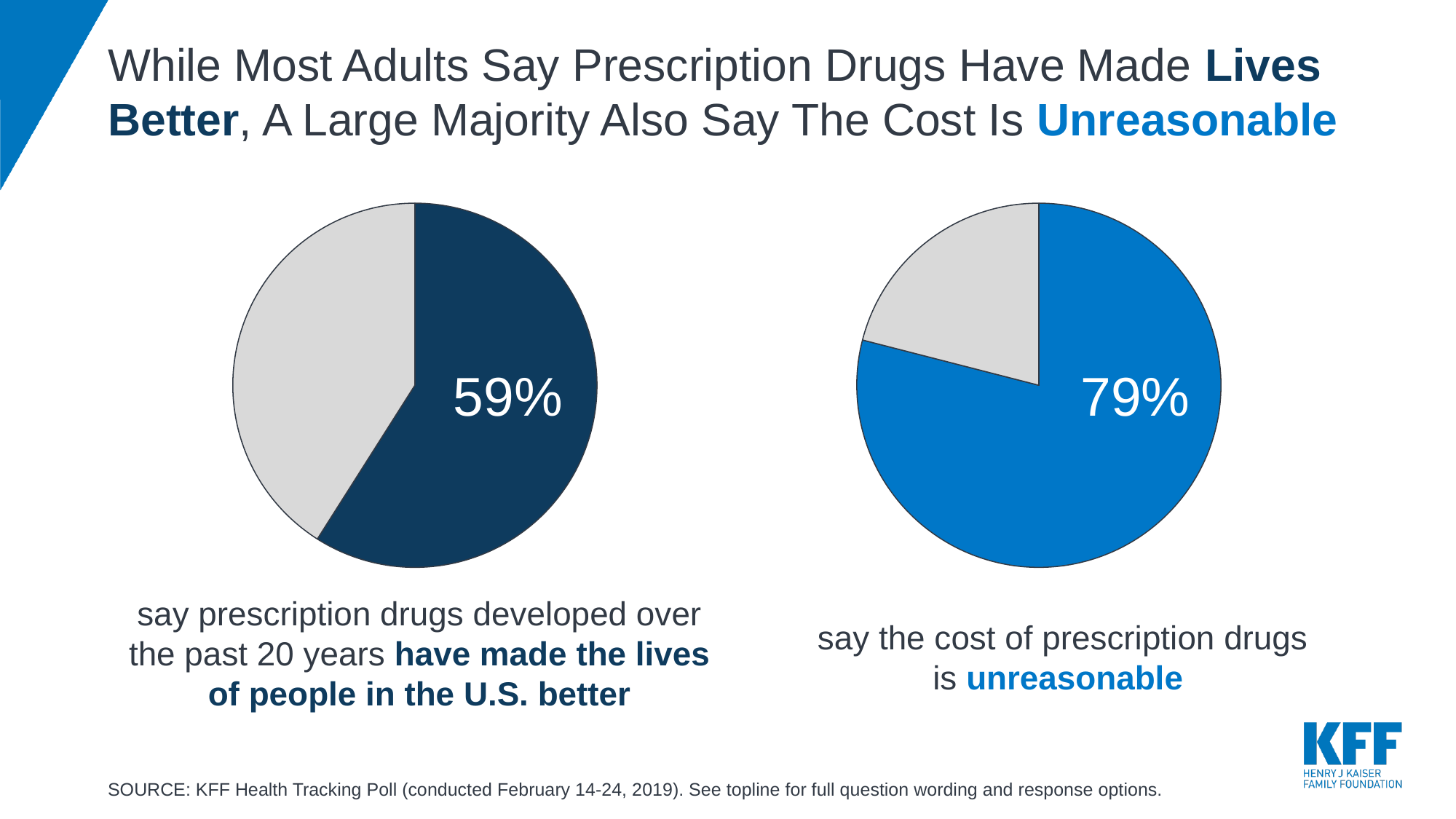
On the left pie chart, what percentage of adults say prescription drugs developed over the past 20 years have made the lives of people in the U.S. better? 59% What kind of chart is used on the right side of the slide? Pie chart Which is larger: the share saying prescription drugs have made lives better (left chart) or the share saying the cost is unreasonable (right chart)? The share saying the cost is unreasonable (79%) What kind of chart is used on the left side of the slide? Pie chart What is the difference in percentage points between the labeled slice of the right pie chart (79%) and the labeled slice of the left pie chart (59%)? 20 percentage points How many pie charts are shown on the slide? 2 What colour is the labeled 79% slice on the right pie chart? Blue What colour is the labeled 59% slice on the left pie chart? Dark navy blue On the right pie chart, is the labeled slice greater or less than 75%? greater On the left pie chart, is the labeled slice greater or less than 50%? greater How many slices does each pie chart on the slide have? 2 On the right pie chart, what percentage of adults say the cost of prescription drugs is unreasonable? 79%